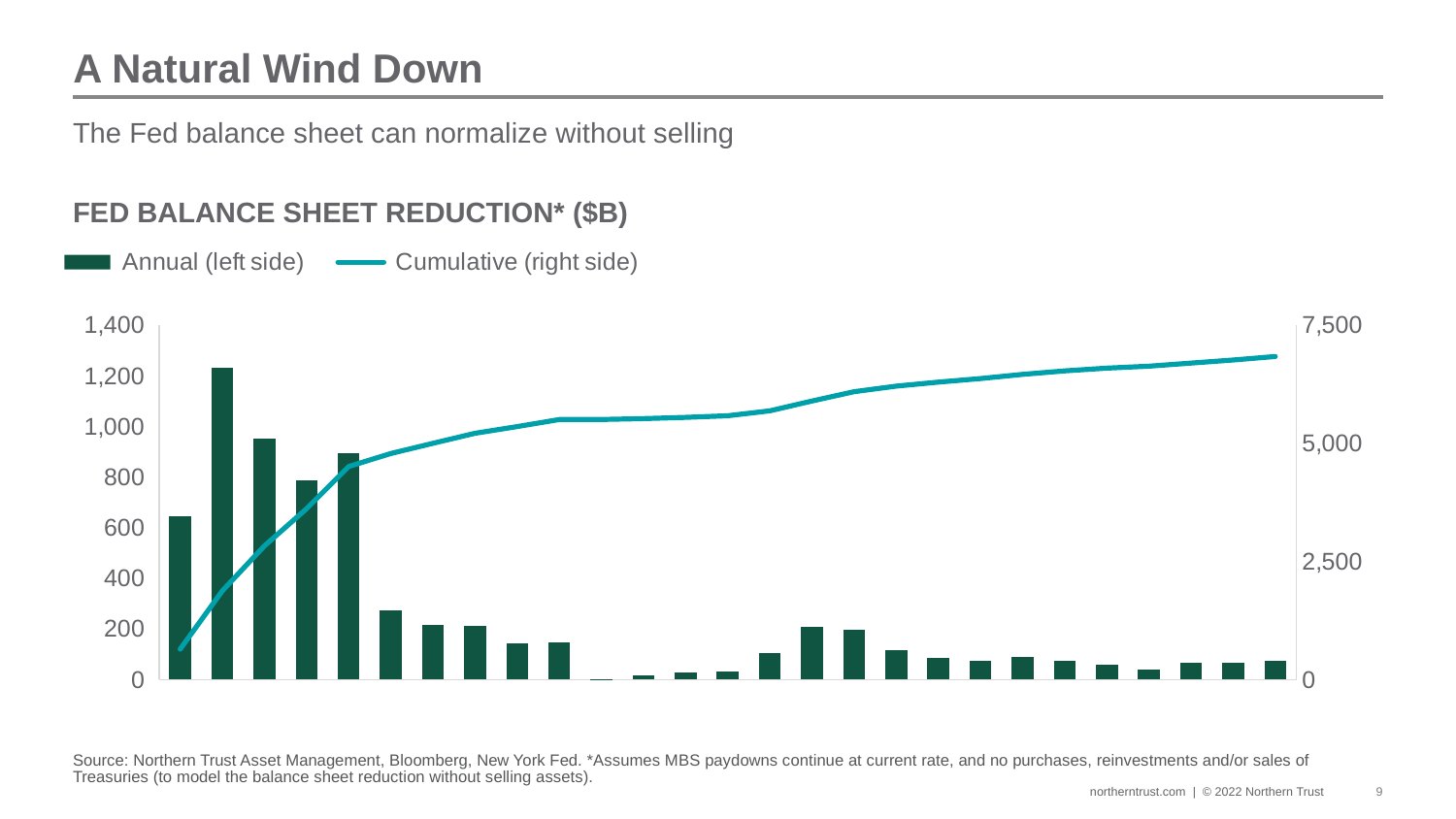
What kind of chart is shown on the slide? A combined bar and line chart Does the Cumulative line rise or fall from left to right? Rises How many series does the legend list? 2 Is the value of the first Annual bar on the left greater or less than 400? greater Which is larger, the first Annual bar from the left or the second Annual bar from the left? The second bar Is the value of the tallest Annual bar greater or less than 1,000? greater What is the highest tick value shown on the left-hand axis? 1,400 Is the final value of the Cumulative line greater or less than 7,500? less What is the title of the chart? FED BALANCE SHEET REDUCTION* ($B) Which series is plotted against the right-hand axis? Cumulative